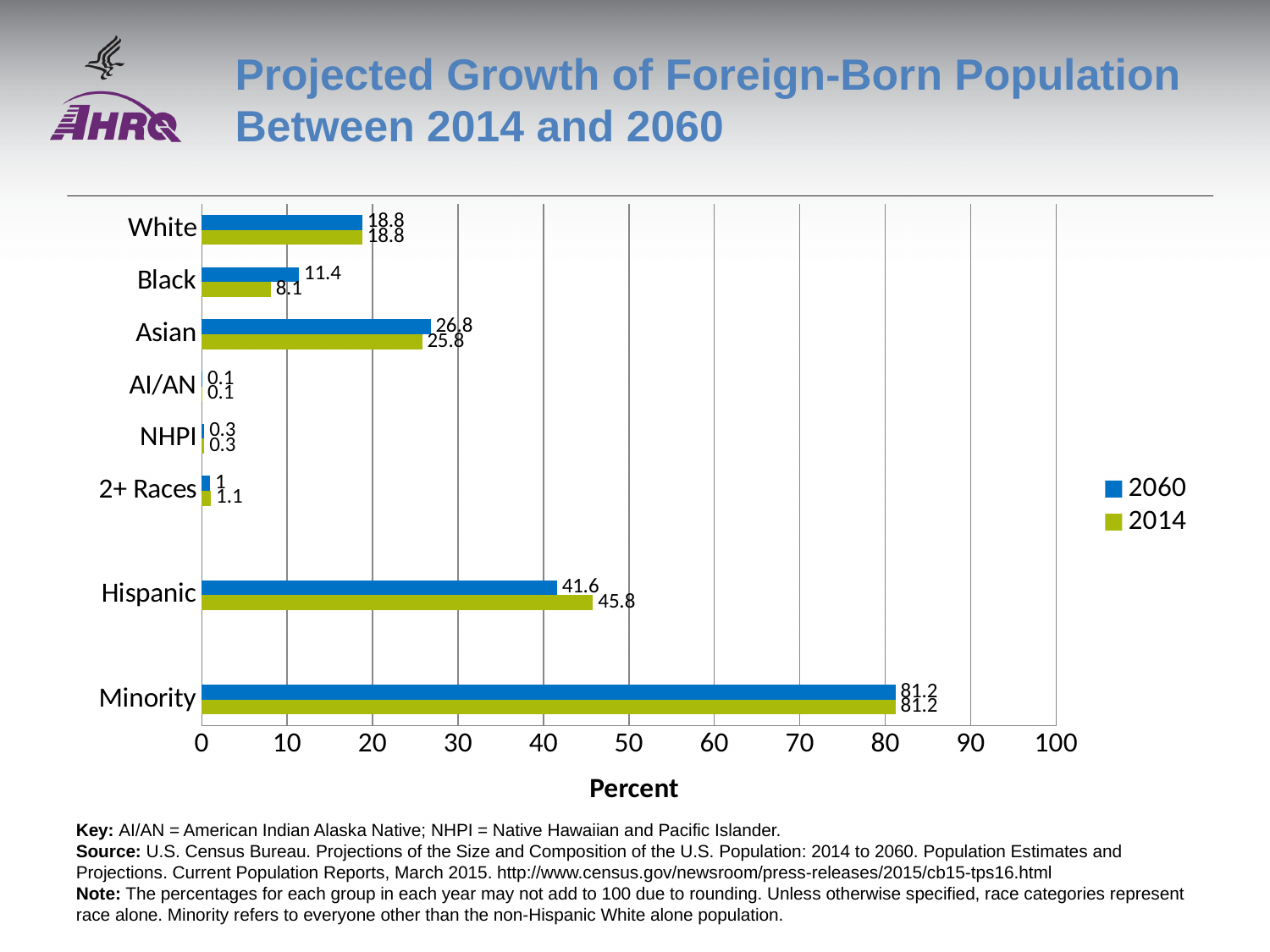
What is the difference between the 2014 and 2060 values for Hispanic? 4.2 How many series does the legend list? 2 What is the 2060 value for Black? 11.4 Which category has the highest 2060 value? Minority Which category has the lowest 2014 value? AI/AN How many categories are shown on the chart? 8 What is the label of the x axis? Percent What is the 2014 value for Hispanic? 45.8 What is the 2014 value for Asian? 25.8 What is the difference between the 2060 and 2014 values for Black? 3.3 For Hispanic, which is larger: the 2060 value or the 2014 value? 2014 What kind of chart is shown on the slide? Bar chart